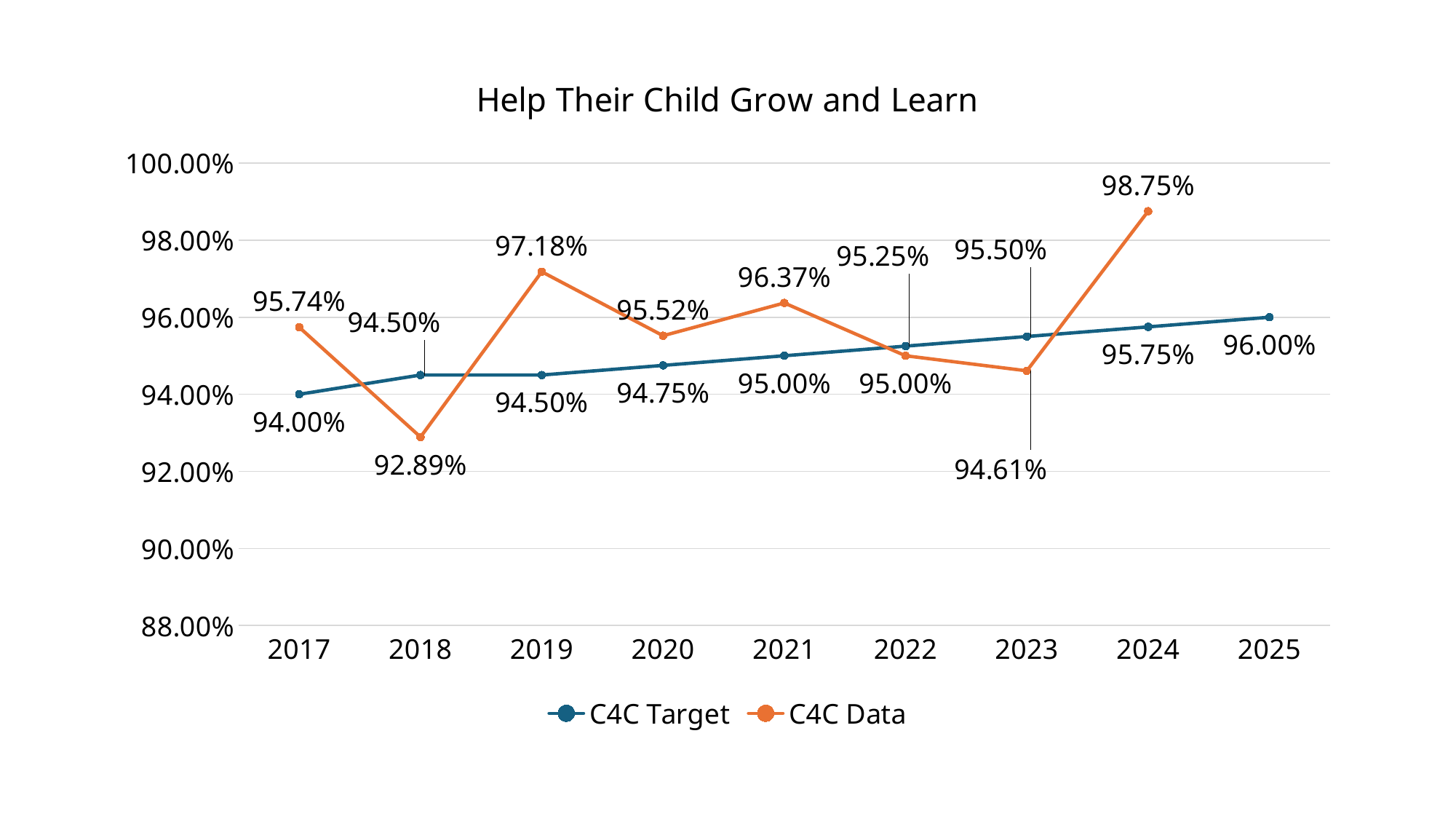
What is the C4C Data value for 2024? 98.75% Does the C4C Target series rise or fall from 2017 to 2025? Rise Is the C4C Data value for 2018 greater or less than 94.00%? less In 2023, which is larger: the C4C Target value or the C4C Data value? C4C Target What is the C4C Data value for 2018? 92.89% How many series does the legend list? 2 How many years are shown on the x axis? 9 What is the C4C Target value for 2025? 96.00% What kind of chart is shown on the slide? Line chart What is the difference between the C4C Data value and the C4C Target value in 2019? 2.68% In which year is the C4C Data value highest? 2024 In which year is the C4C Data value lowest? 2018